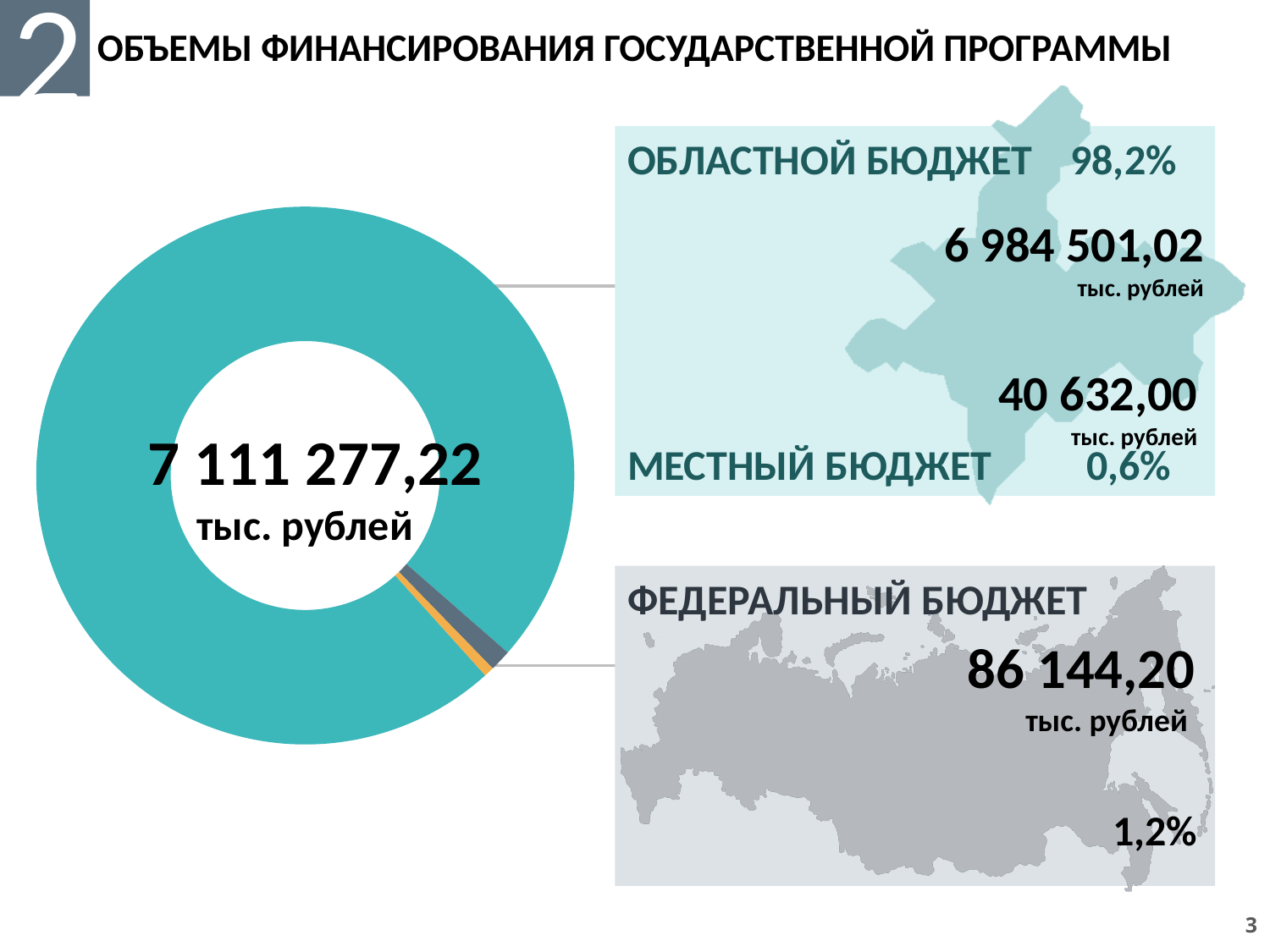
What is the value for ОБЛАСТНОЙ БЮДЖЕТ? 6 984 501,02 тыс. рублей Which budget source has the largest share of the total? ОБЛАСТНОЙ БЮДЖЕТ Which is larger, the value for ФЕДЕРАЛЬНЫЙ БЮДЖЕТ or the value for МЕСТНЫЙ БЮДЖЕТ? ФЕДЕРАЛЬНЫЙ БЮДЖЕТ What kind of chart is shown on the slide? doughnut chart What share of the total does ФЕДЕРАЛЬНЫЙ БЮДЖЕТ represent? 1,2% What share of the total does ОБЛАСТНОЙ БЮДЖЕТ represent? 98,2% What is the difference between the value for ФЕДЕРАЛЬНЫЙ БЮДЖЕТ and the value for МЕСТНЫЙ БЮДЖЕТ? 45 512,20 тыс. рублей What is the value for МЕСТНЫЙ БЮДЖЕТ? 40 632,00 тыс. рублей What is the value for ФЕДЕРАЛЬНЫЙ БЮДЖЕТ? 86 144,20 тыс. рублей What share of the total does МЕСТНЫЙ БЮДЖЕТ represent? 0,6% Which budget source has the smallest share of the total? МЕСТНЫЙ БЮДЖЕТ What is the total amount shown in the centre of the chart? 7 111 277,22 тыс. рублей